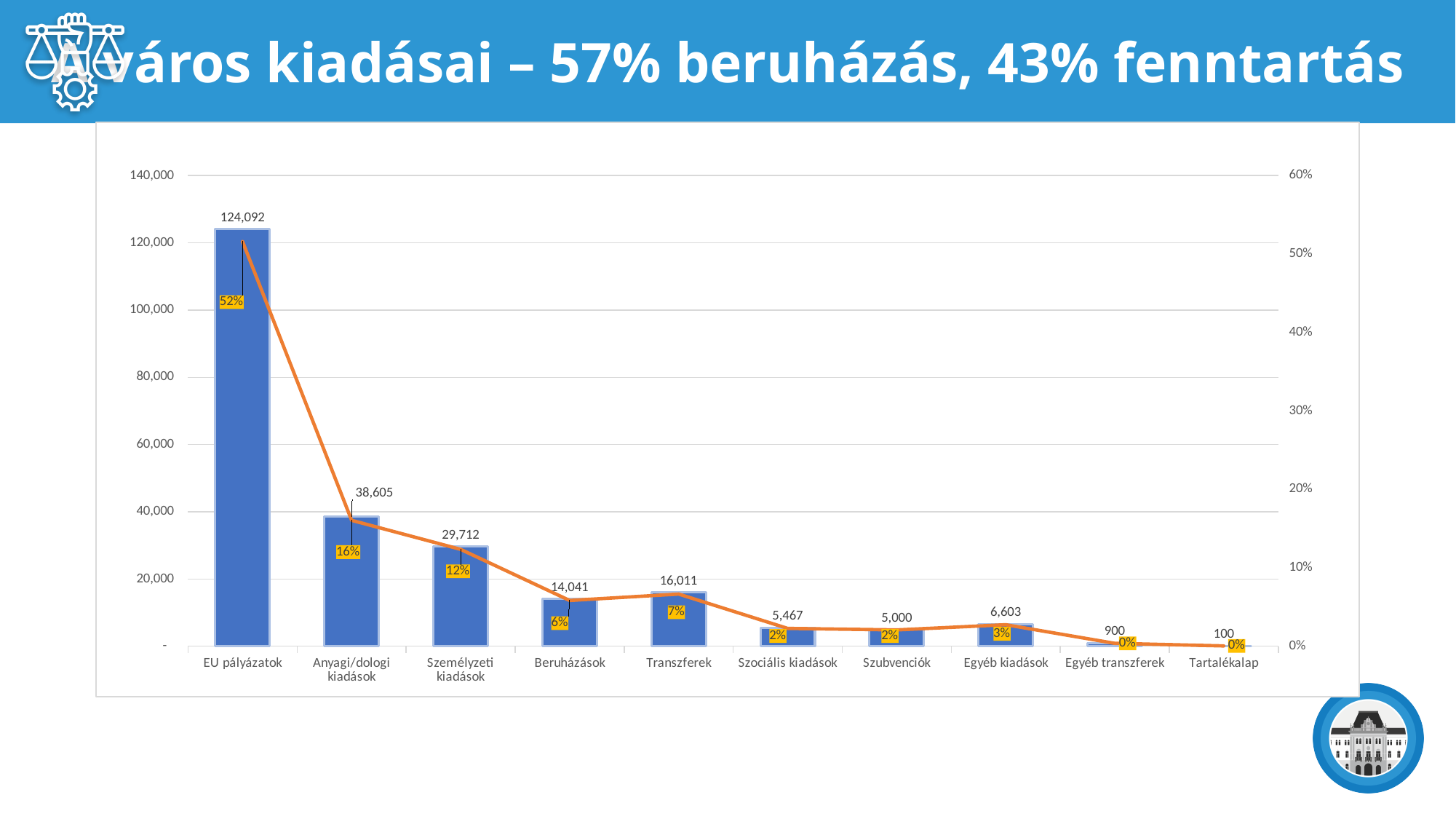
How many categories are shown on the x axis? 10 Which category has the highest bar value? EU pályázatok What is the value of the bar for Transzferek? 16,011 Is the bar value for Anyagi/dologi kiadások greater or less than 40,000? less What kind of chart is shown on the slide? Bar chart with a line overlay What is the difference between the bar values for Transzferek and Beruházások? 1,970 What percentage is shown on the line for Személyzeti kiadások? 12% What is the value of the bar for EU pályázatok? 124,092 Which category has the lowest bar value? Tartalékalap What is the value of the bar for Anyagi/dologi kiadások? 38,605 What percentage is shown on the line for EU pályázatok? 52% Which has a larger bar value, Szociális kiadások or Egyéb kiadások? Egyéb kiadások